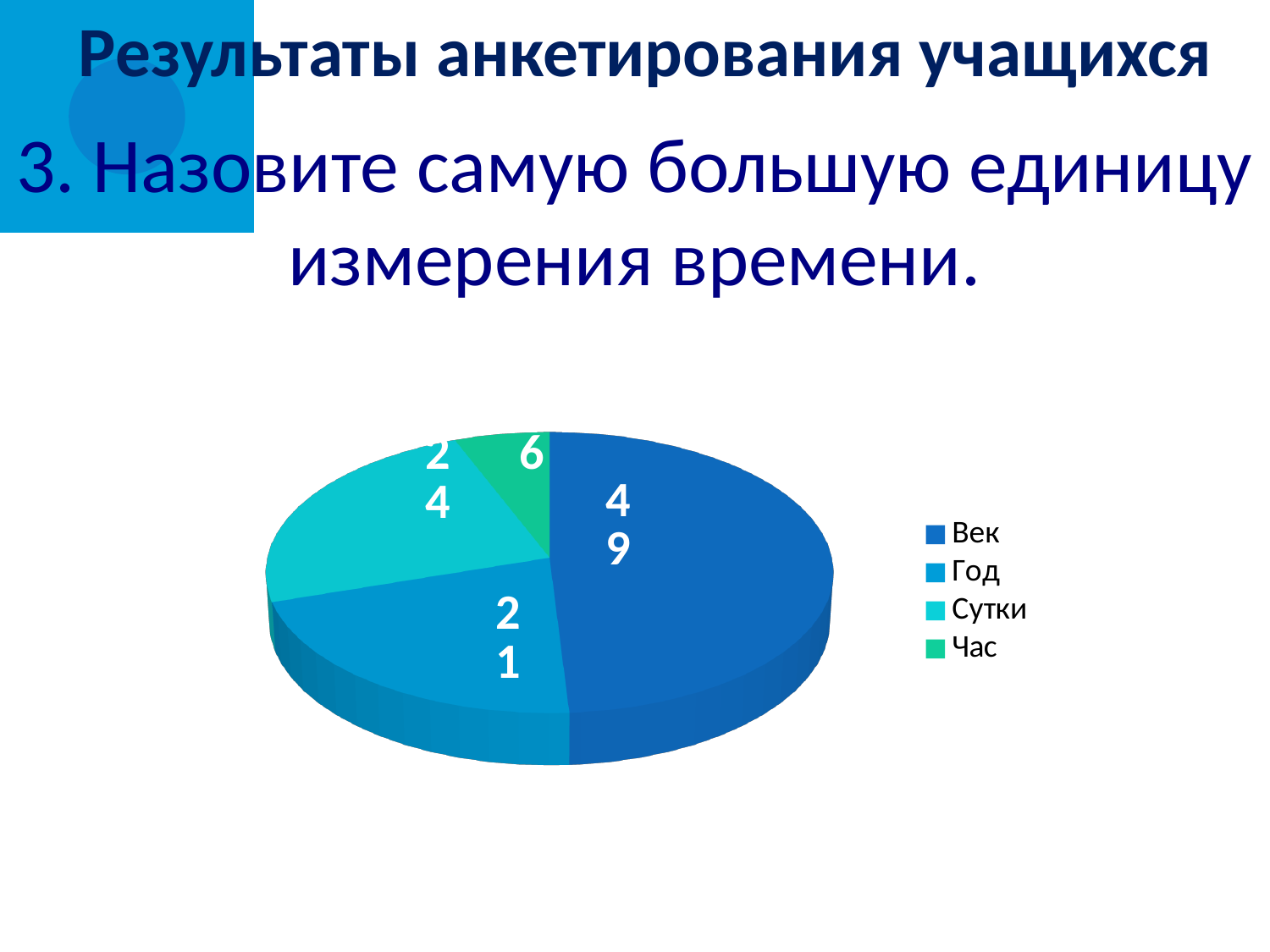
How many categories does the pie chart have? 4 Which category has the smallest slice in the pie chart? Час What is the value for Век in the pie chart? 49 What is the difference between the values for Век and Год? 28 What is the value for Сутки in the pie chart? 24 What kind of chart is shown on the slide? pie chart Which category has the largest slice in the pie chart? Век What is the value for Час in the pie chart? 6 What is the total of all the slice values in the pie chart? 100 What is the value for Год in the pie chart? 21 Which legend entry is listed first in the pie chart's legend? Век Which is larger, the value for Сутки or the value for Год? Сутки